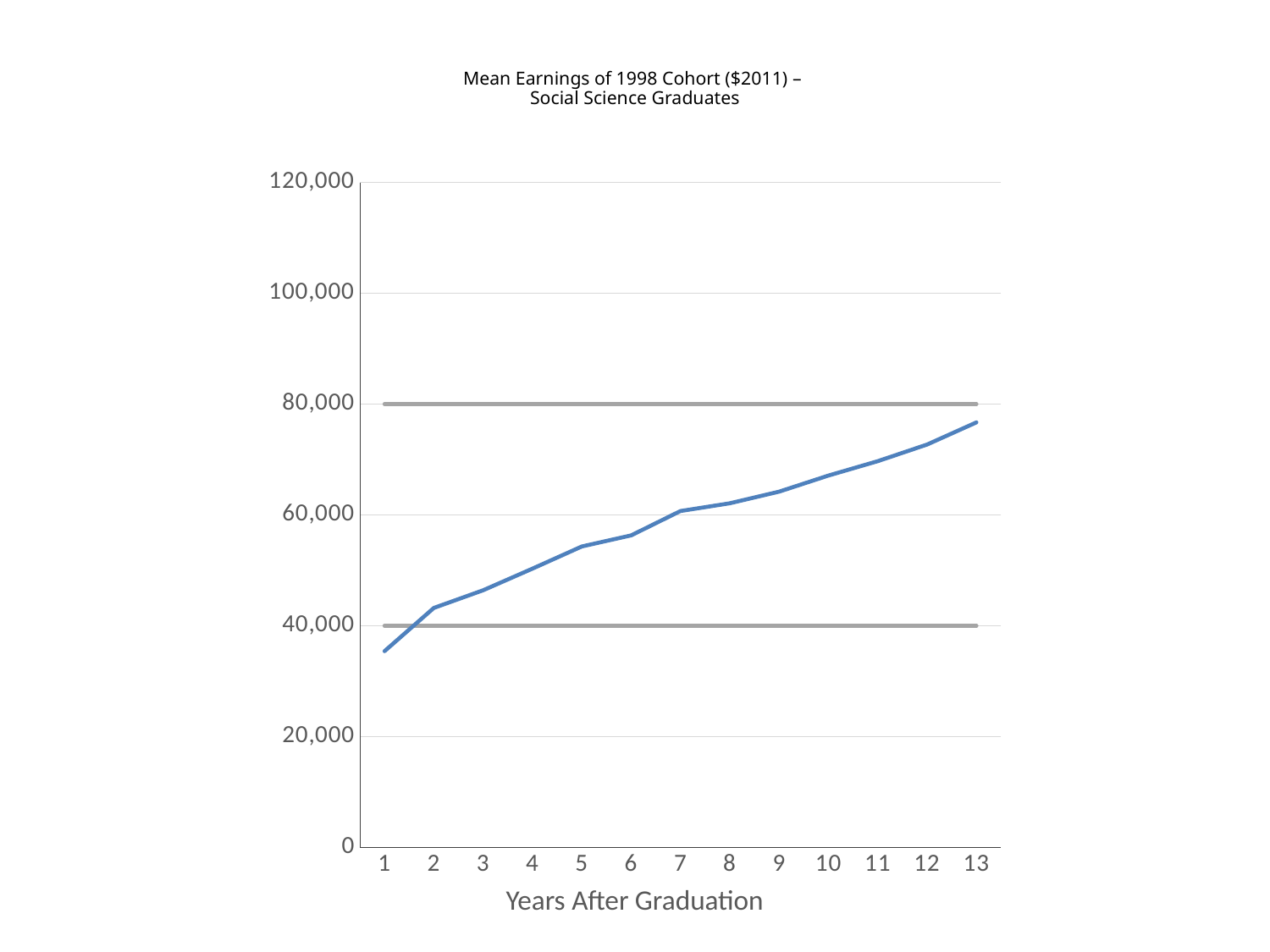
Is the value for year 4 greater or less than 60,000? less What is the title of the chart? Mean Earnings of 1998 Cohort ($2011) – Social Science Graduates At which year after graduation are mean earnings lowest? 1 Do mean earnings rise or fall as years after graduation increase? rise Is the value for year 1 greater or less than 40,000? less Which is larger, the value for year 2 or the value for year 10? year 10 How many years after graduation are plotted along the x axis? 13 What is the label of the x axis? Years After Graduation What kind of chart is shown on the slide? line chart At which year after graduation are mean earnings highest? 13 Is the value for year 13 greater or less than 80,000? less